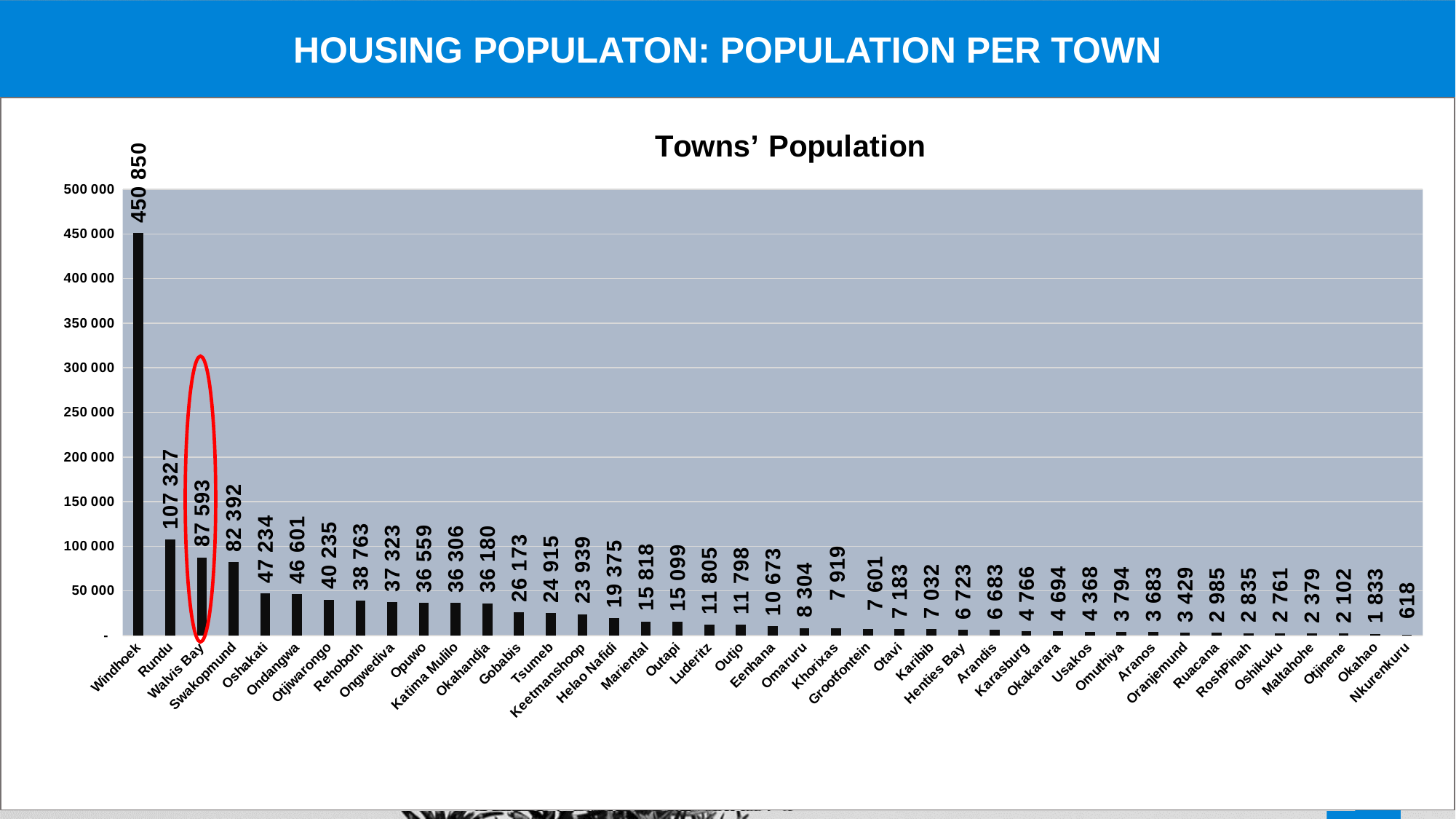
Is the value for Rundu greater or less than 100 000? greater What is the difference between the populations of Windhoek and Rundu? 343 523 What kind of chart is shown on the slide? Bar chart What is the population shown for Walvis Bay? 87 593 What is the title of the chart? Towns' Population What is the difference between the populations of Walvis Bay and Swakopmund? 5 201 Which town has the lowest population in the chart? Nkurenkuru How many towns are shown in the chart? 41 Which town has the highest population in the chart? Windhoek What is the population shown for Windhoek? 450 850 Which has a larger population, Oshakati or Ondangwa? Oshakati What is the population shown for Keetmanshoop? 23 939